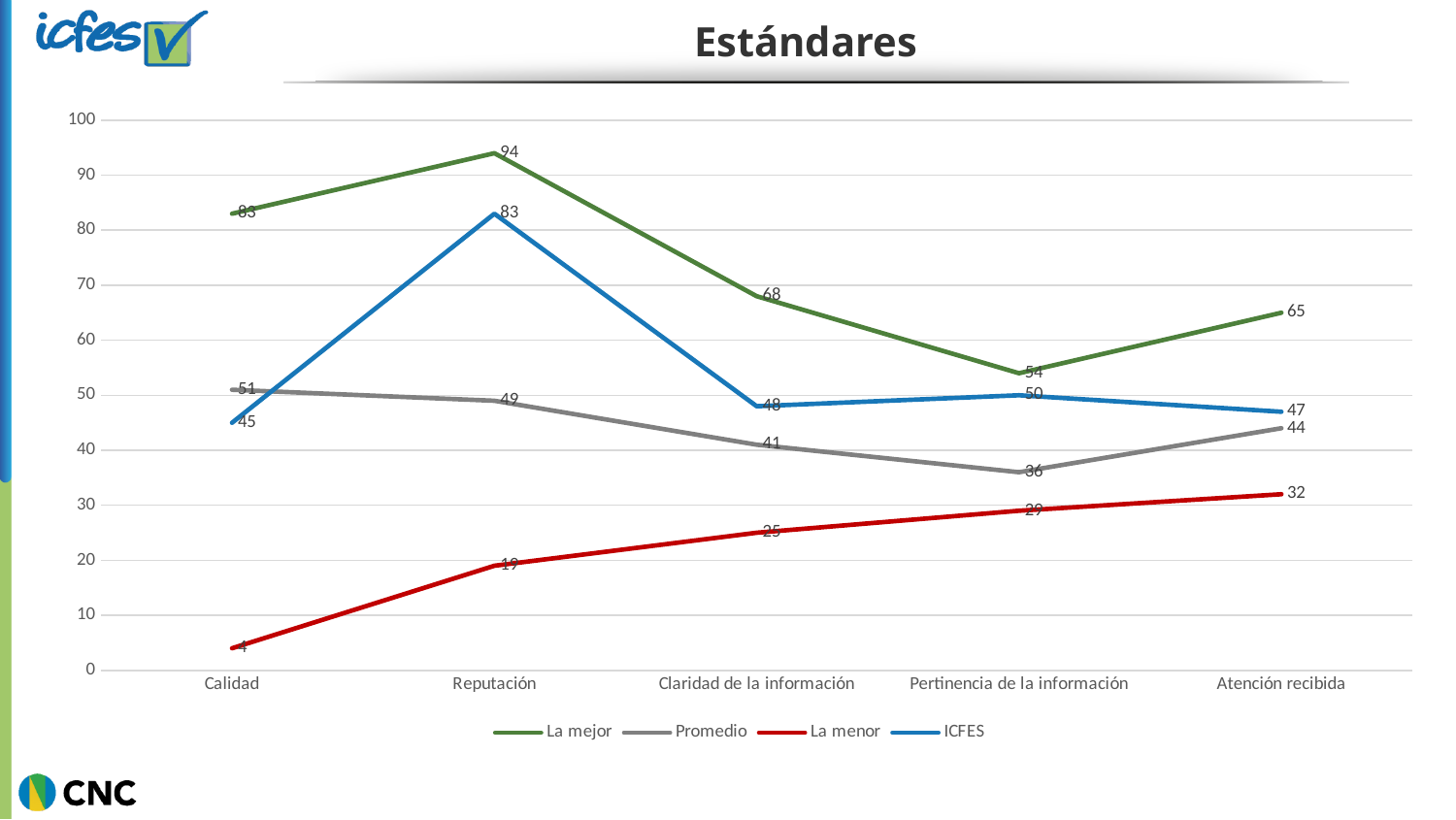
Does the La menor series rise or fall from Calidad to Atención recibida? rise How many categories are shown on the x axis? 5 Which is larger for Atención recibida: the ICFES value or the Promedio value? ICFES What type of chart is shown on the slide? line chart What is the value of the Promedio series for Pertinencia de la información? 36 What is the difference between the La mejor and ICFES values for Calidad? 38 What is the value of the ICFES series for Reputación? 83 For which category is the Promedio series lowest? Pertinencia de la información What is the value of the La mejor series for Claridad de la información? 68 For which category is the La mejor series highest? Reputación What is the value of the La menor series for Atención recibida? 32 How many series does the legend list? 4